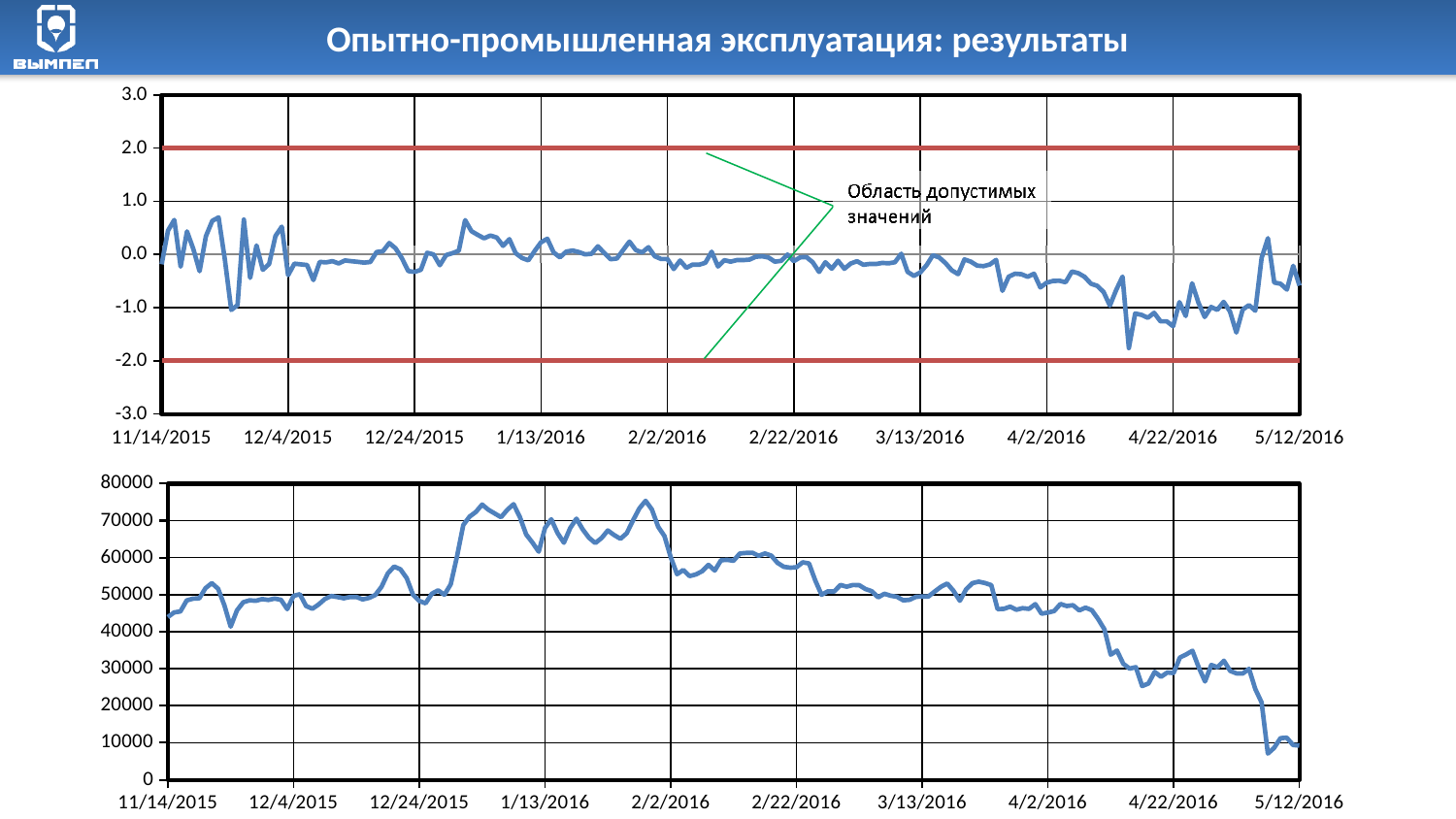
In the top chart, what does the annotation label the region between the red lines? Область допустимых значений In the bottom chart, is the value at 4/22/2016 greater or less than 40000? less In the bottom chart, is the value at 5/12/2016 greater or less than 20000? less What kind of chart is the bottom chart on the slide? line chart In the bottom chart, is the value at 11/14/2015 greater or less than 40000? greater In the bottom chart, does the line rise or fall between 4/2/2016 and 5/12/2016? fall In the top chart, at what values are the two red horizontal lines drawn? 2.0 and -2.0 What kind of chart is the top chart on the slide? line chart